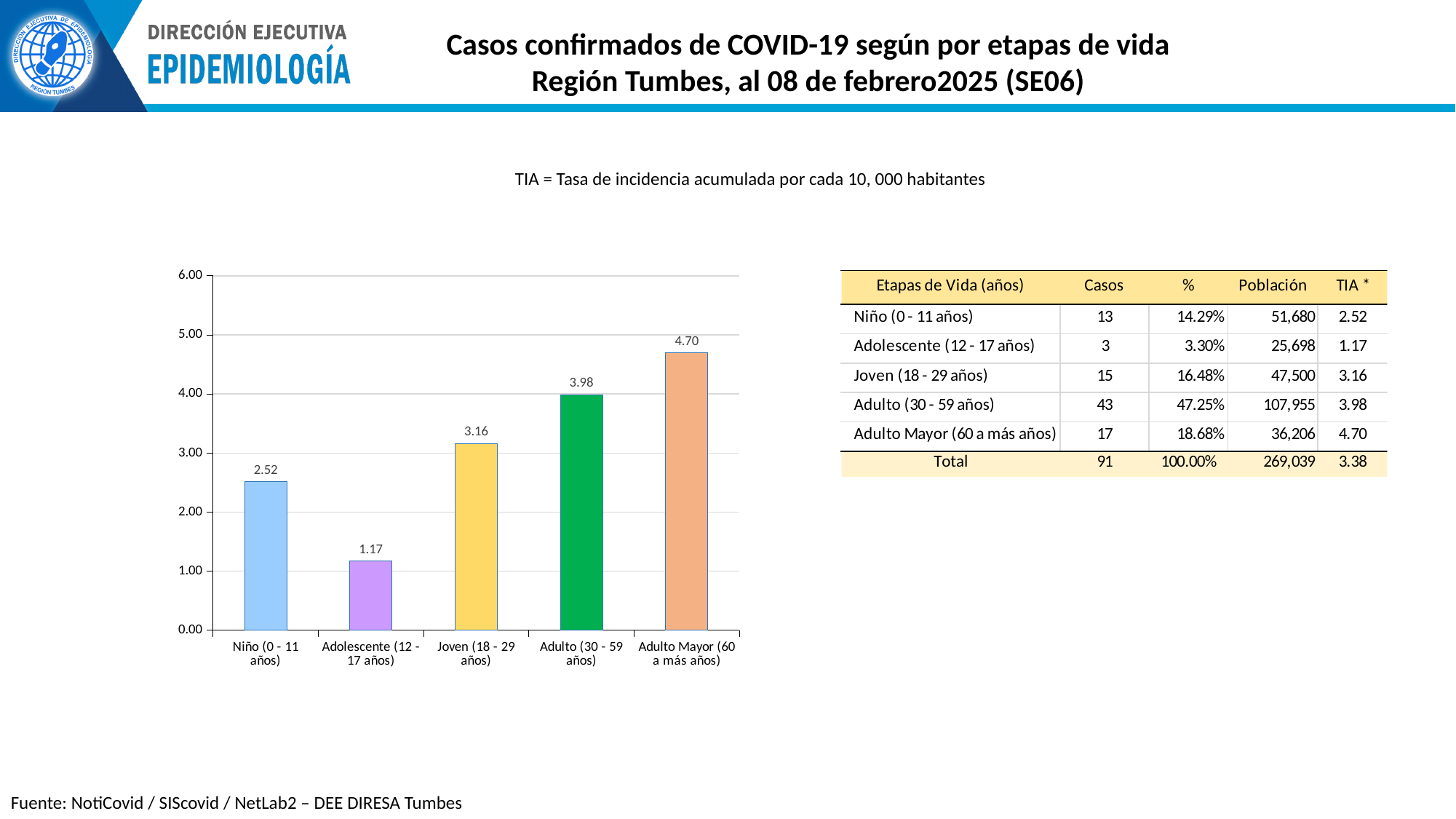
What is the TIA value shown for Niño (0 - 11 años) in the bar chart? 2.52 Which life stage has the highest bar in the chart? Adulto Mayor (60 a más años) What is the value of the bar for Joven (18 - 29 años)? 3.16 What is the value of the bar for Adulto (30 - 59 años)? 3.98 How many life-stage categories are plotted in the bar chart? 5 Is the value for Adulto (30 - 59 años) greater or less than 3.00? greater Which life stage has the lowest bar in the chart? Adolescente (12 - 17 años) Which bar is taller: Niño (0 - 11 años) or Joven (18 - 29 años)? Joven (18 - 29 años) What is the difference between the bar values for Adulto Mayor (60 a más años) and Adulto (30 - 59 años)? 0.72 What is the maximum value shown on the vertical axis of the chart? 6.00 What is the value of the bar for Adolescente (12 - 17 años)? 1.17 What kind of chart is shown on the slide? Bar chart